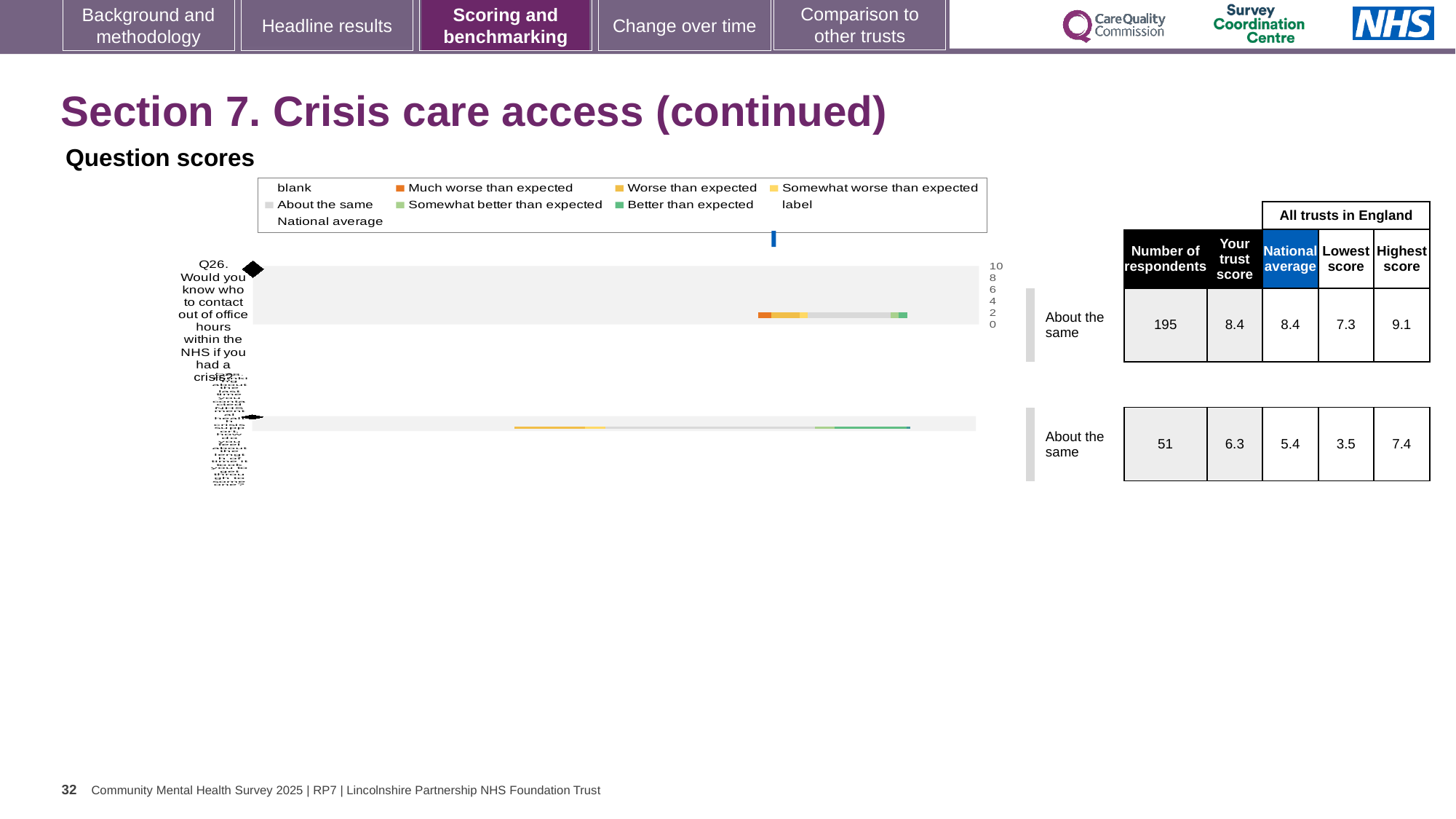
What is the highest score among all trusts in England for Q26? 9.1 What benchmark category is shown for Q26? About the same What is the trust score for Q26 (Would you know who to contact out of office hours within the NHS if you had a crisis?)? 8.4 In the second question row (below Q26), what is the trust score? 6.3 In the second question row (below Q26), how much higher is the trust score than the national average? 0.9 What is the national average score for Q26? 8.4 For Q26, is the trust score higher than, lower than, or the same as the national average? the same What is the difference between the highest and lowest trust scores in England for Q26? 1.8 How many question rows are plotted in the question scores chart? 2 What kind of chart is used to show the question scores on this slide? bar chart What is the lowest score among all trusts in England for Q26? 7.3 How many respondents answered Q26? 195